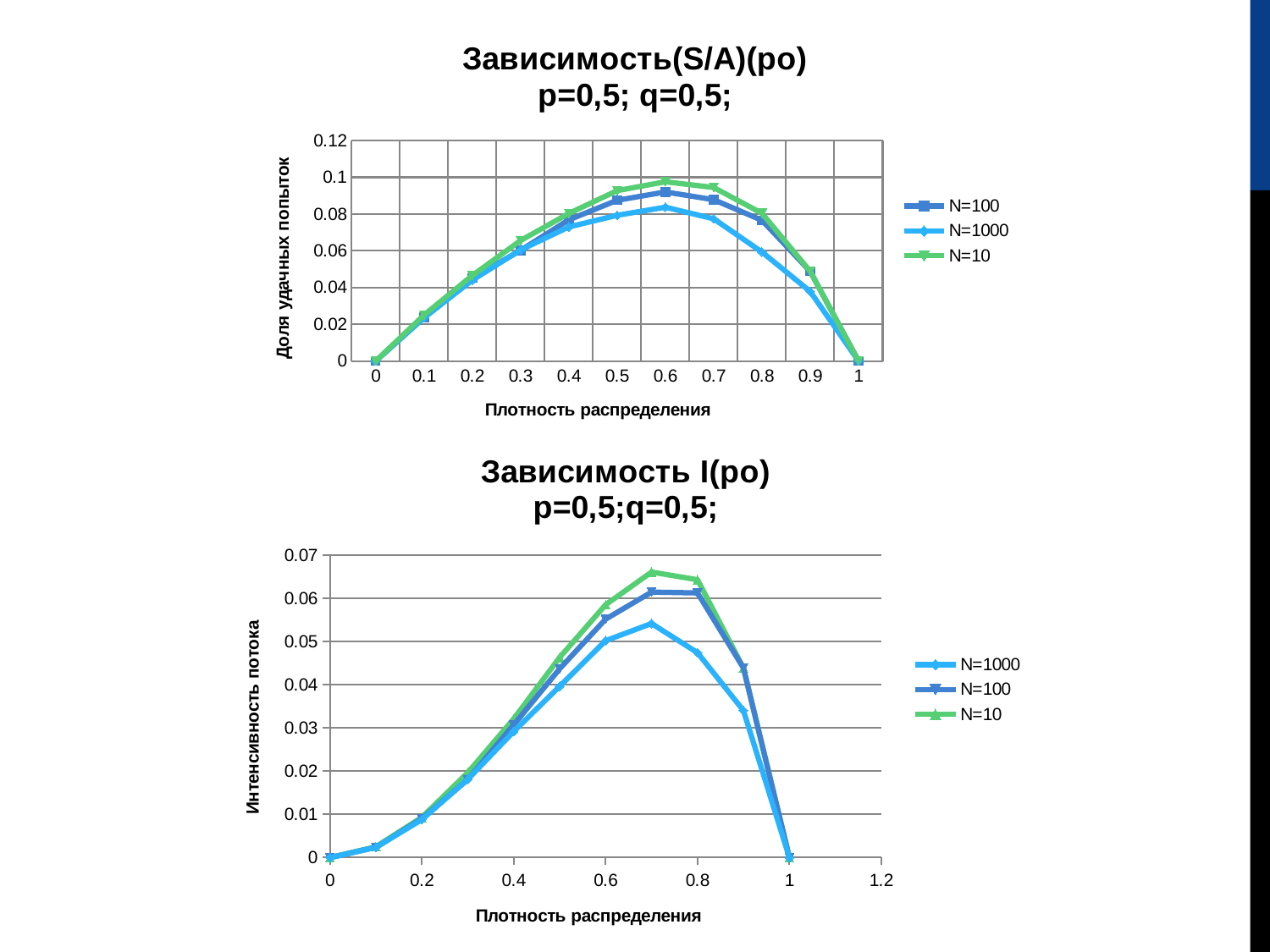
In the bottom chart "Зависимость I(ро)", which series has the highest value at x = 0.7? N=10 In the top chart "Зависимость(S/A)(ро)", what is the value of all series at x = 1? 0 What type of chart is the top chart titled "Зависимость(S/A)(ро)"? line chart What is the y-axis title of the bottom chart "Зависимость I(ро)"? Интенсивность потока In the top chart "Зависимость(S/A)(ро)", which series has the highest value at x = 0.6? N=10 In the top chart "Зависимость(S/A)(ро)", which series has the lowest value at x = 0.6? N=1000 In the bottom chart "Зависимость I(ро)", do the values of N=10 rise or fall between x = 0.7 and x = 1? fall In the top chart "Зависимость(S/A)(ро)", how many x-axis points are plotted for each series? 11 In the bottom chart "Зависимость I(ро)", is the value of N=1000 at x = 0.7 greater or less than 0.06? less How many series does the legend of the top chart "Зависимость(S/A)(ро)" list? 3 In the top chart "Зависимость(S/A)(ро)", is the value of N=10 at x = 0.6 greater or less than 0.08? greater In the top chart "Зависимость(S/A)(ро)", is the value of N=100 at x = 0.9 greater or less than 0.06? less